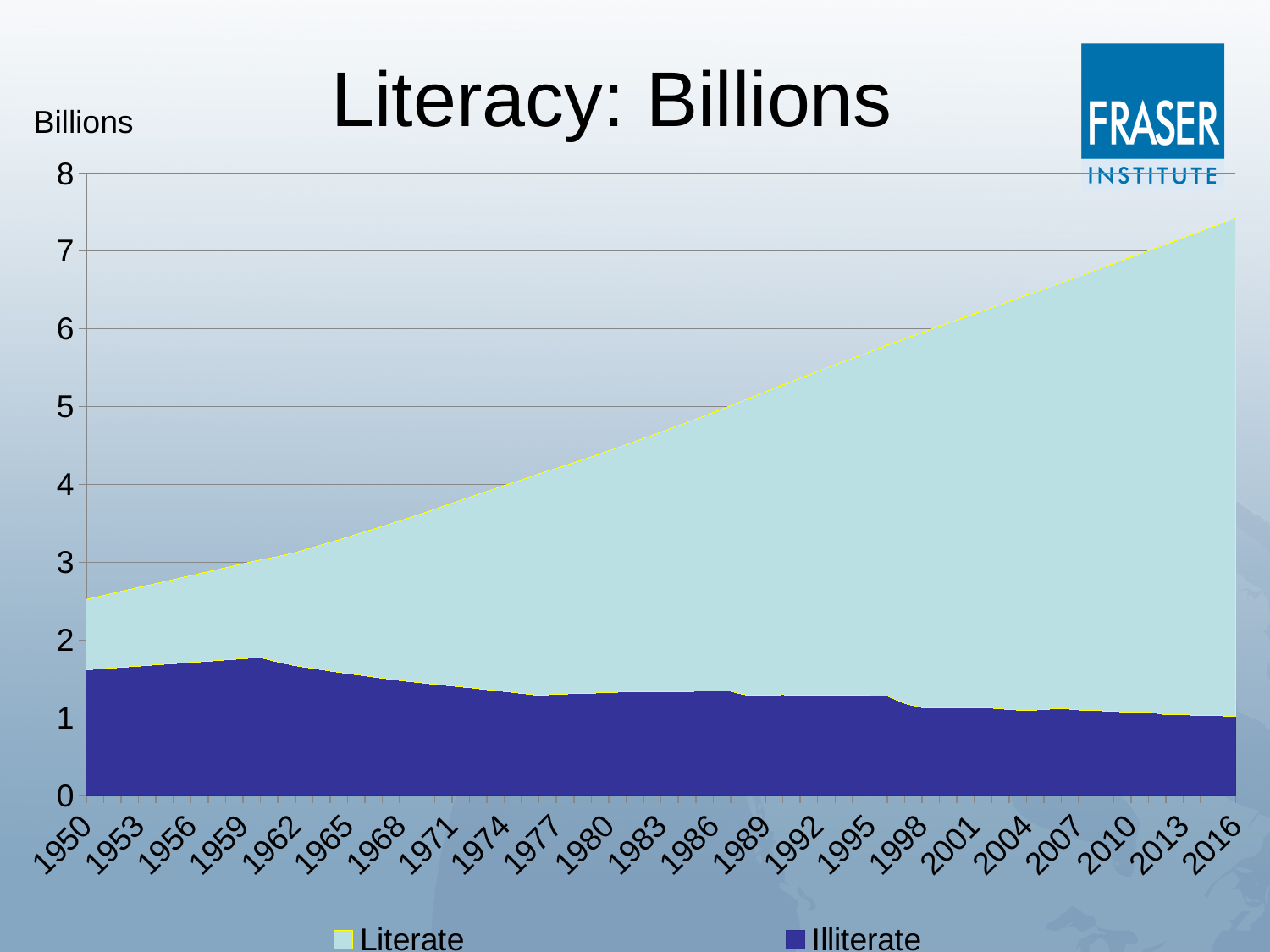
What kind of chart is shown on the slide? Stacked area chart Is the total stacked value in 1980 greater or less than 4? greater What are the two series named in the legend? Literate and Illiterate Is the Illiterate value in 1950 greater or less than 1? greater What is the title of the chart? Literacy: Billions How many series does the legend list? 2 How many year labels are shown on the x axis? 23 Does the total (Literate plus Illiterate) rise or fall from 1950 to 2016? Rise Is the total stacked value in 1950 greater or less than 3? less Which is larger, the Illiterate value in 1950 or the Illiterate value in 2016? 1950